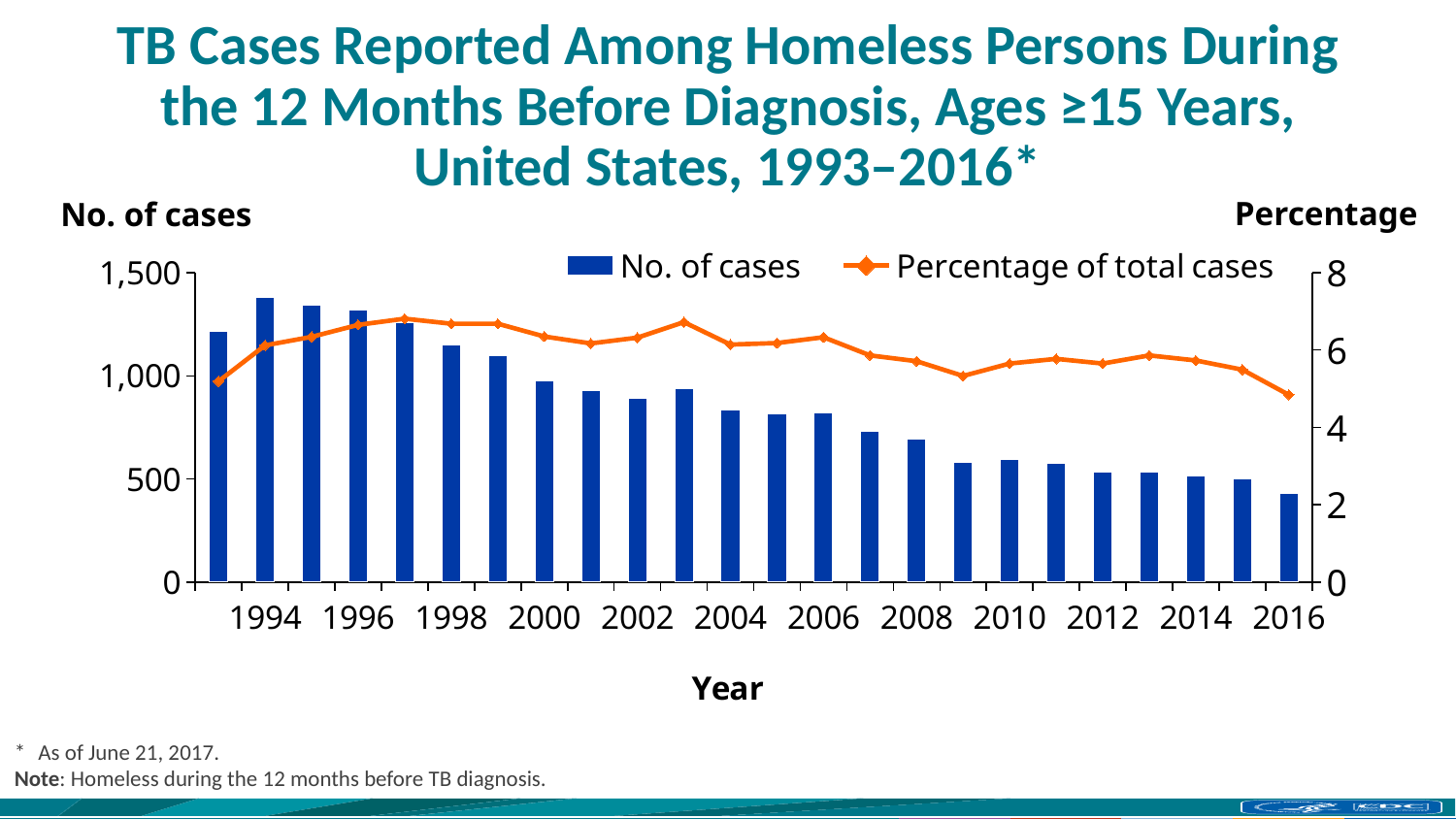
Is the number of cases in 2016 greater or less than 500? less What is the label of the right-hand vertical axis? Percentage Is the percentage of total cases in 2016 greater or less than 4? greater Which is larger, the number of cases in 1994 or in 2016? 1994 How many series does the legend list? 2 What kind of chart is shown on the slide? A combination bar and line chart Is the percentage of total cases in 2009 greater or less than 6? less Does the number of cases generally rise or fall from 1993 to 2016? fall How many years are plotted along the x axis? 24 Which year has the highest number of cases? 1994 Which year has the lowest number of cases? 2016